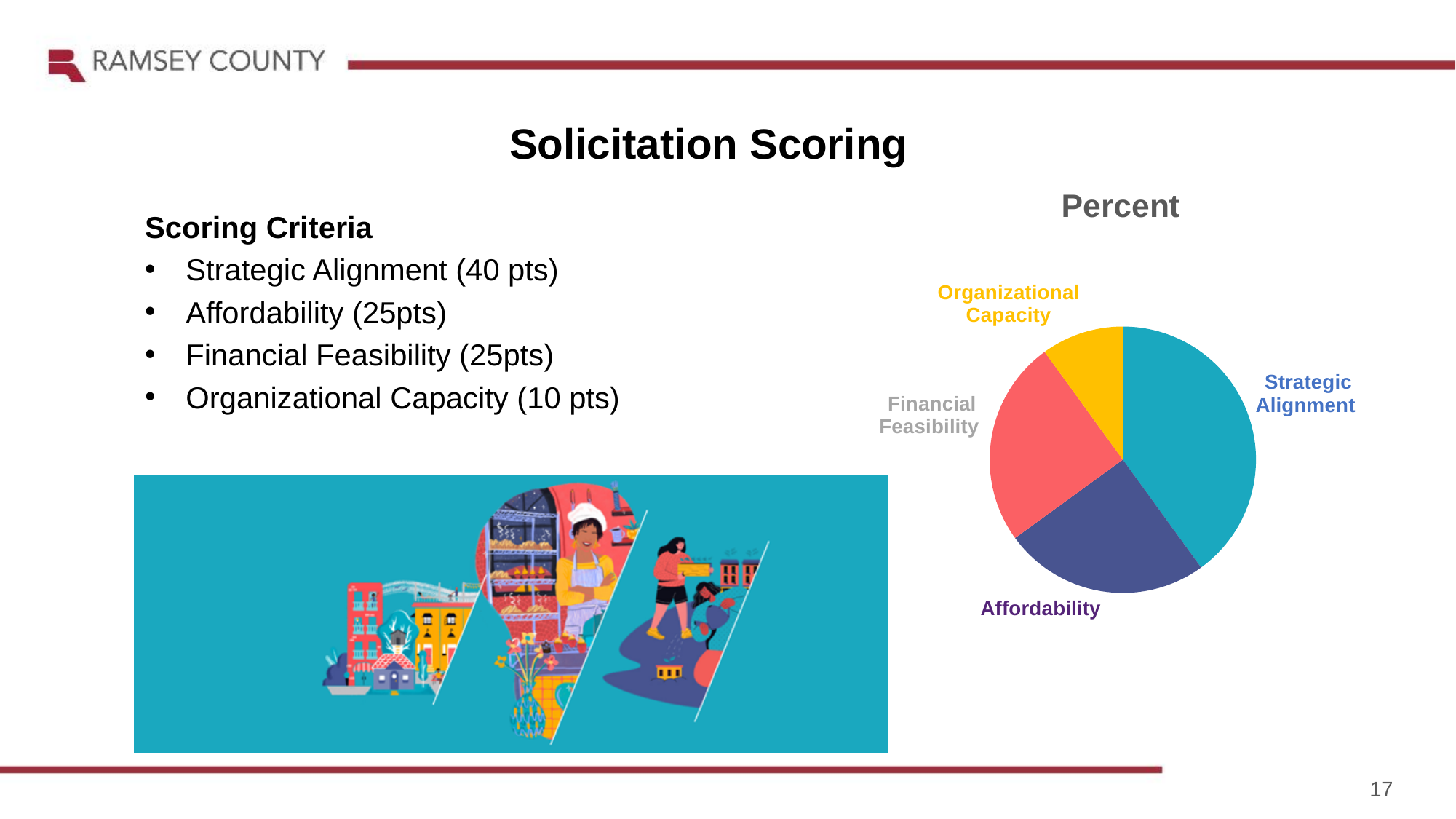
How many slices does the pie chart have? 4 Which slice is larger in the pie chart, Financial Feasibility or Organizational Capacity? Financial Feasibility Which slice is larger in the pie chart, Strategic Alignment or Affordability? Strategic Alignment What is the title of the pie chart? Percent Which slice is larger in the pie chart, Organizational Capacity or Affordability? Affordability Which category has the largest slice in the pie chart? Strategic Alignment What kind of chart is shown on the slide? pie chart Which category has the smallest slice in the pie chart? Organizational Capacity What colour is the Organizational Capacity slice in the pie chart? yellow